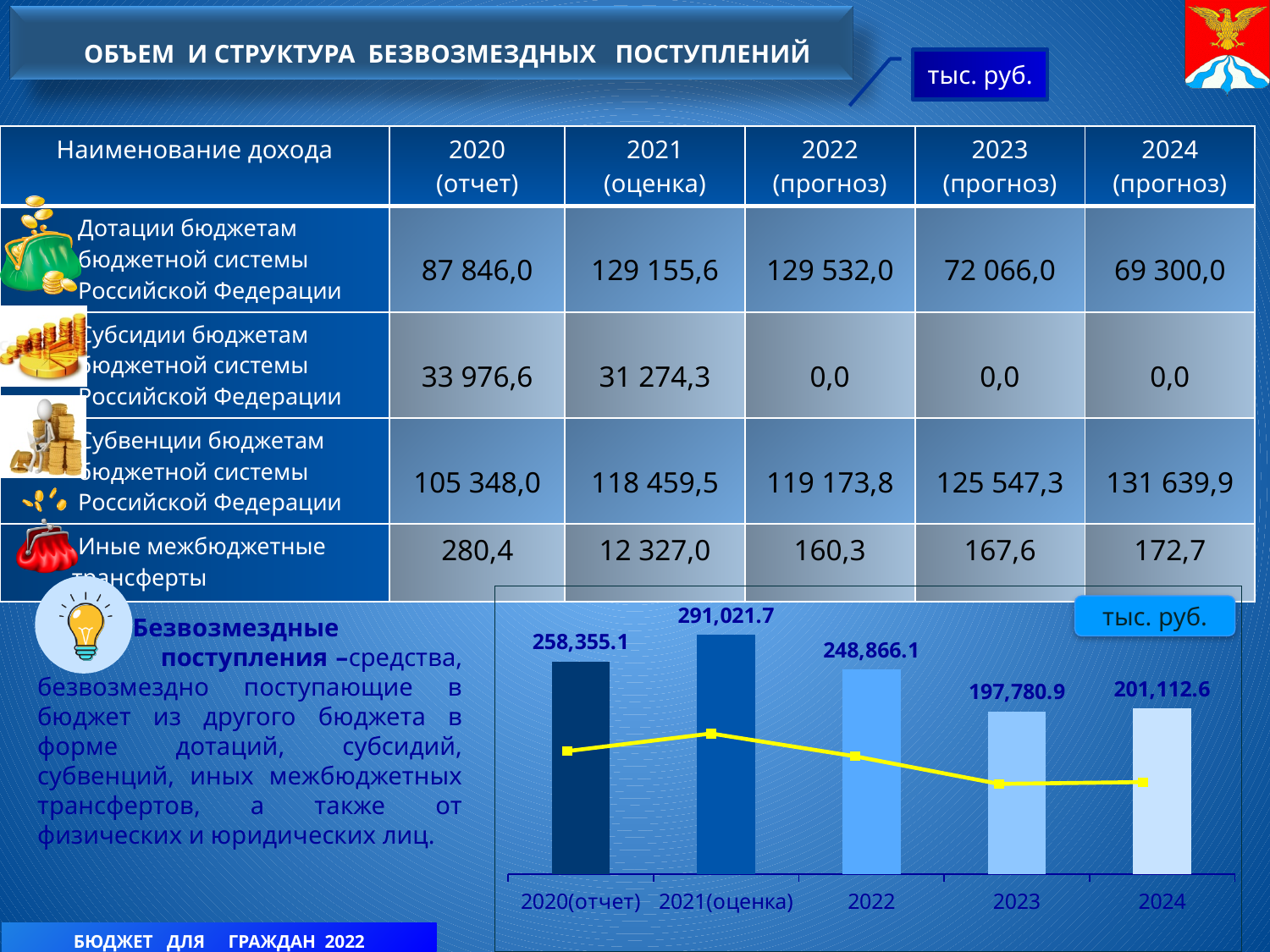
Which year has the highest bar in the chart? 2021(оценка) What is the value of the bar for 2024 in the chart? 201,112.6 Which year has the lowest bar in the chart? 2023 How many years are shown on the x axis of the chart? 5 Which bar is larger, 2022 or 2024? 2022 What is the value of the bar for 2021(оценка) in the chart? 291,021.7 Between 2021(оценка) and 2023, do the bar values rise or fall? fall What unit label is shown in the top-right corner of the chart? тыс. руб. What is the value of the bar for 2022 in the chart? 248,866.1 What is the difference between the bar values for 2024 and 2023? 3,331.7 What is the value of the bar for 2020(отчет) in the chart? 258,355.1 What is the difference between the bar values for 2021(оценка) and 2020(отчет)? 32,666.6